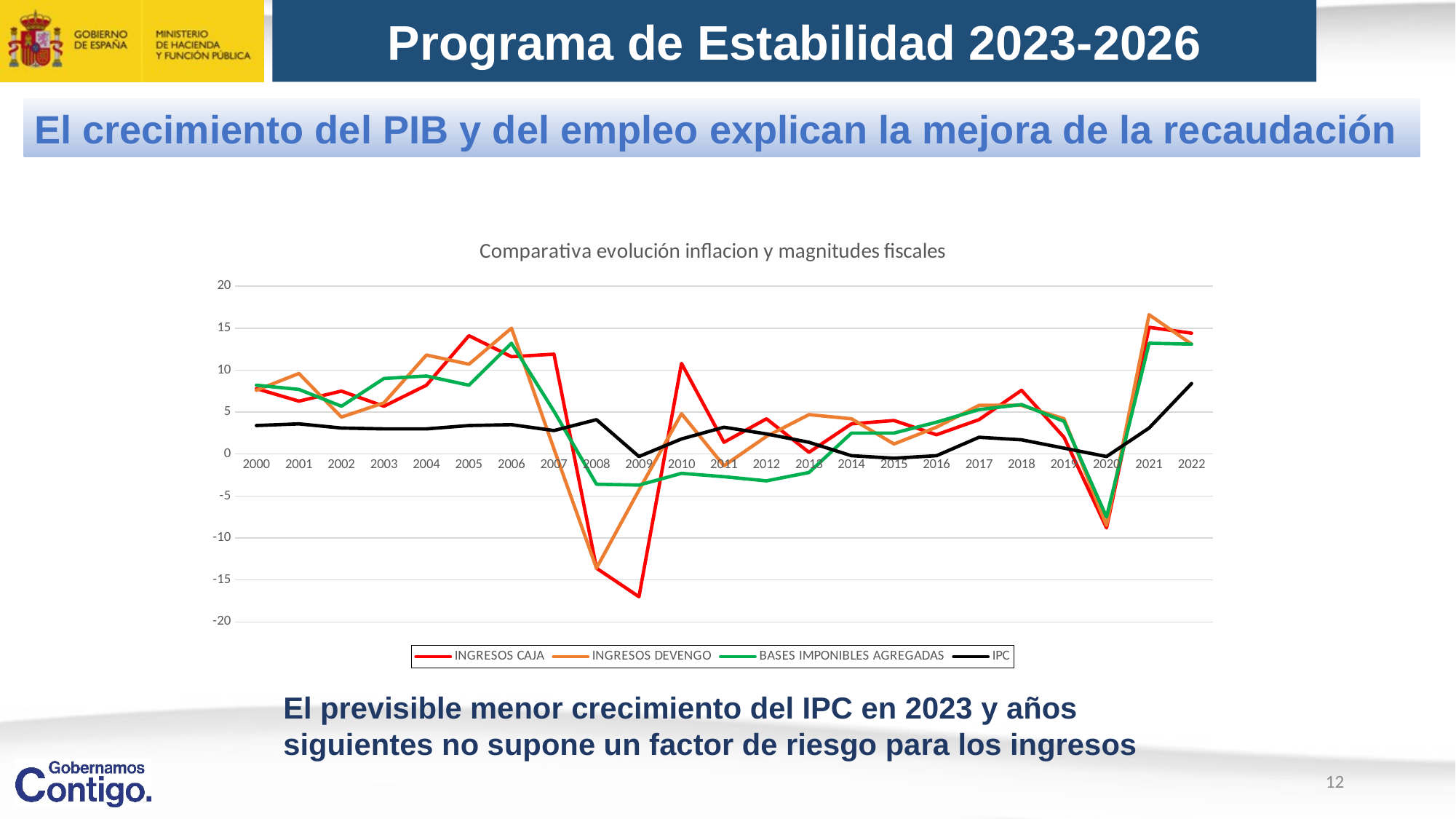
Is the value for INGRESOS DEVENGO in 2021 greater or less than 15? greater In 2009, which series has the higher value, INGRESOS CAJA or IPC? IPC Is the value for INGRESOS CAJA in 2009 greater or less than -10? less In which year does the INGRESOS CAJA series reach its lowest value? 2009 What is the title of the chart? Comparativa evolución inflacion y magnitudes fiscales What kind of chart is shown on the slide? line chart In which year does the IPC series reach its highest value? 2022 How many years are plotted along the x axis of the chart? 23 How many series does the chart legend list? 4 Does the IPC series rise or fall from 2020 to 2022? rise Is the value for BASES IMPONIBLES AGREGADAS in 2008 greater or less than 0? less What colour is the IPC line in the chart? black